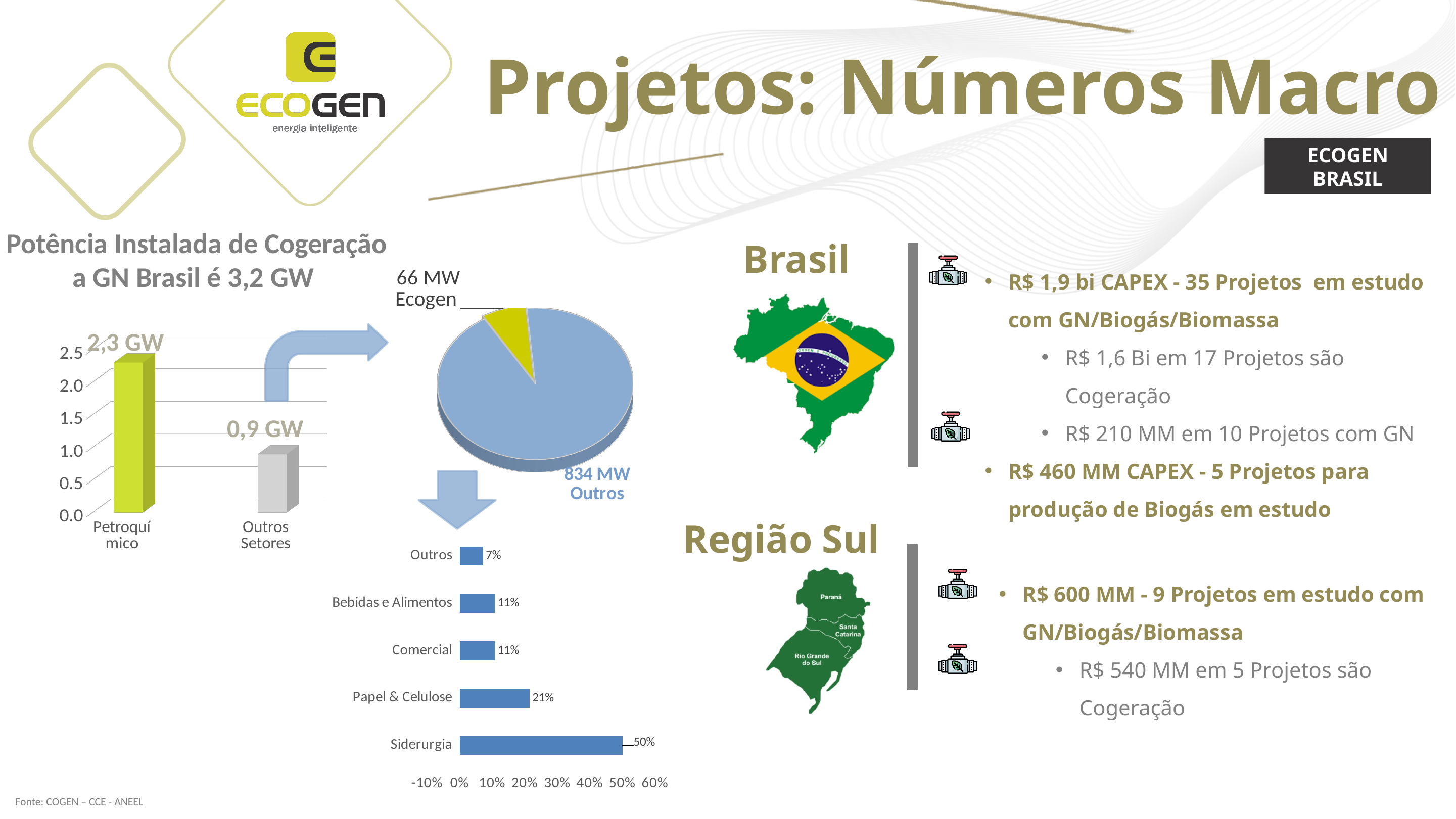
In the horizontal bar chart at the bottom of the slide, how many categories are shown? 5 In the horizontal bar chart at the bottom of the slide, what is the value for Siderurgia? 50% In the horizontal bar chart at the bottom of the slide, what is the difference between Siderurgia and Papel & Celulose? 29% In the pie chart in the middle of the slide, which slice is larger, Ecogen or Outros? Outros In the bar chart on the left (Potência Instalada de Cogeração a GN Brasil), how many categories are shown? 2 In the horizontal bar chart at the bottom of the slide, what is the value for Papel & Celulose? 21% In the bar chart on the left (Potência Instalada de Cogeração a GN Brasil), what is the value for Petroquímico? 2,3 GW In the pie chart in the middle of the slide, what is the value of the Ecogen slice? 66 MW In the bar chart on the left (Potência Instalada de Cogeração a GN Brasil), which category has the higher value? Petroquímico In the bar chart on the left (Potência Instalada de Cogeração a GN Brasil), what is the value for Outros Setores? 0,9 GW In the horizontal bar chart at the bottom of the slide, which category has the lowest value? Outros In the pie chart in the middle of the slide, what is the value of the Outros slice? 834 MW